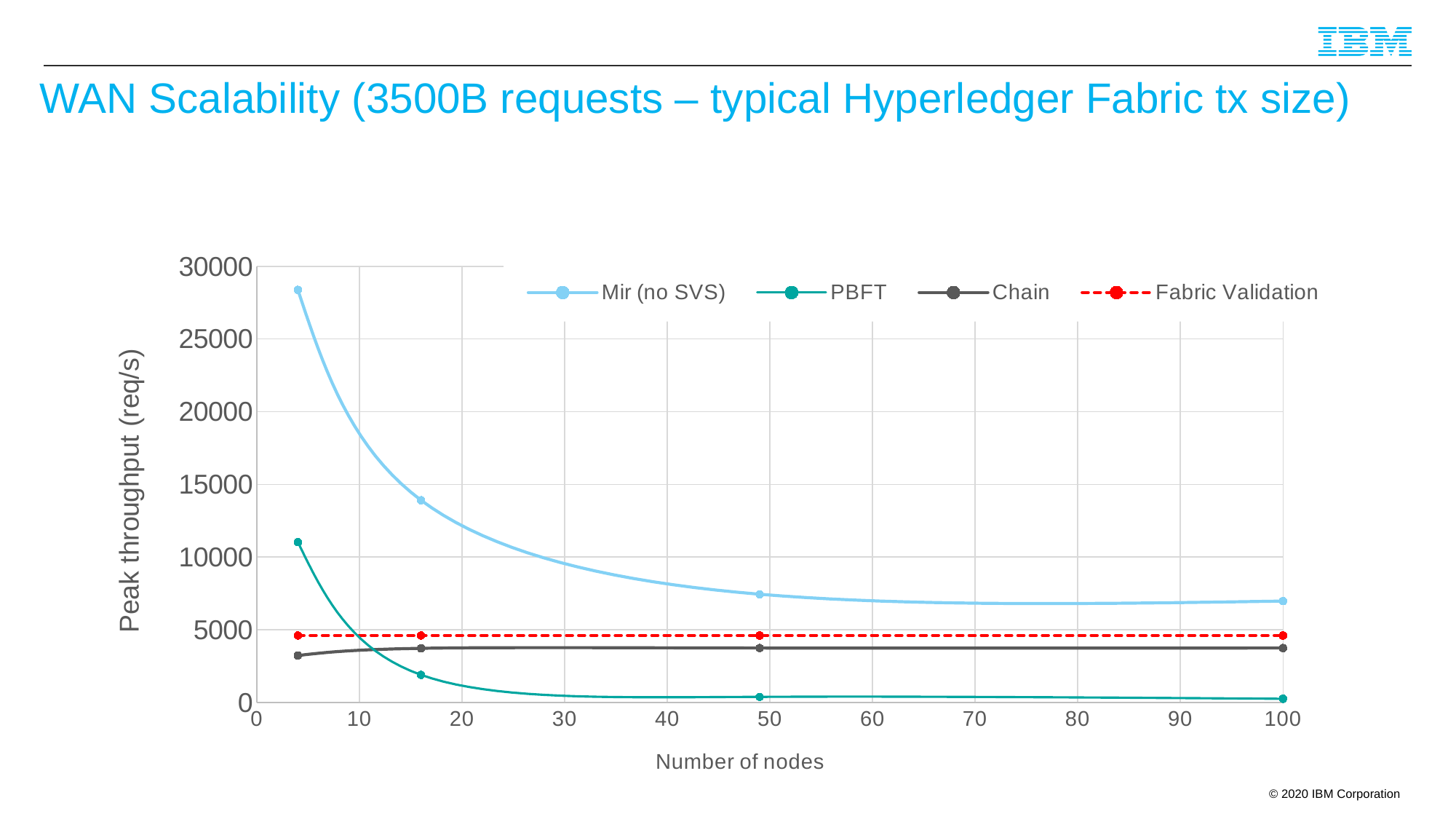
Does the PBFT throughput rise or fall as the number of nodes increases? fall At 49 nodes, which is larger: the Fabric Validation value or the Chain value? Fabric Validation What is the label of the y axis? Peak throughput (req/s) Which series has the lowest throughput at 100 nodes? PBFT Is the PBFT value at 100 nodes greater or less than 5000? less What kind of chart is shown on the slide? line chart Is the Mir (no SVS) value at 4 nodes greater or less than 25000? greater How many series does the legend list? 4 Is the PBFT value at 4 nodes greater or less than 10000? greater Which series is drawn with a dashed red line? Fabric Validation Does the Mir (no SVS) throughput rise or fall as the number of nodes increases? fall Which series has the highest throughput at 100 nodes? Mir (no SVS)